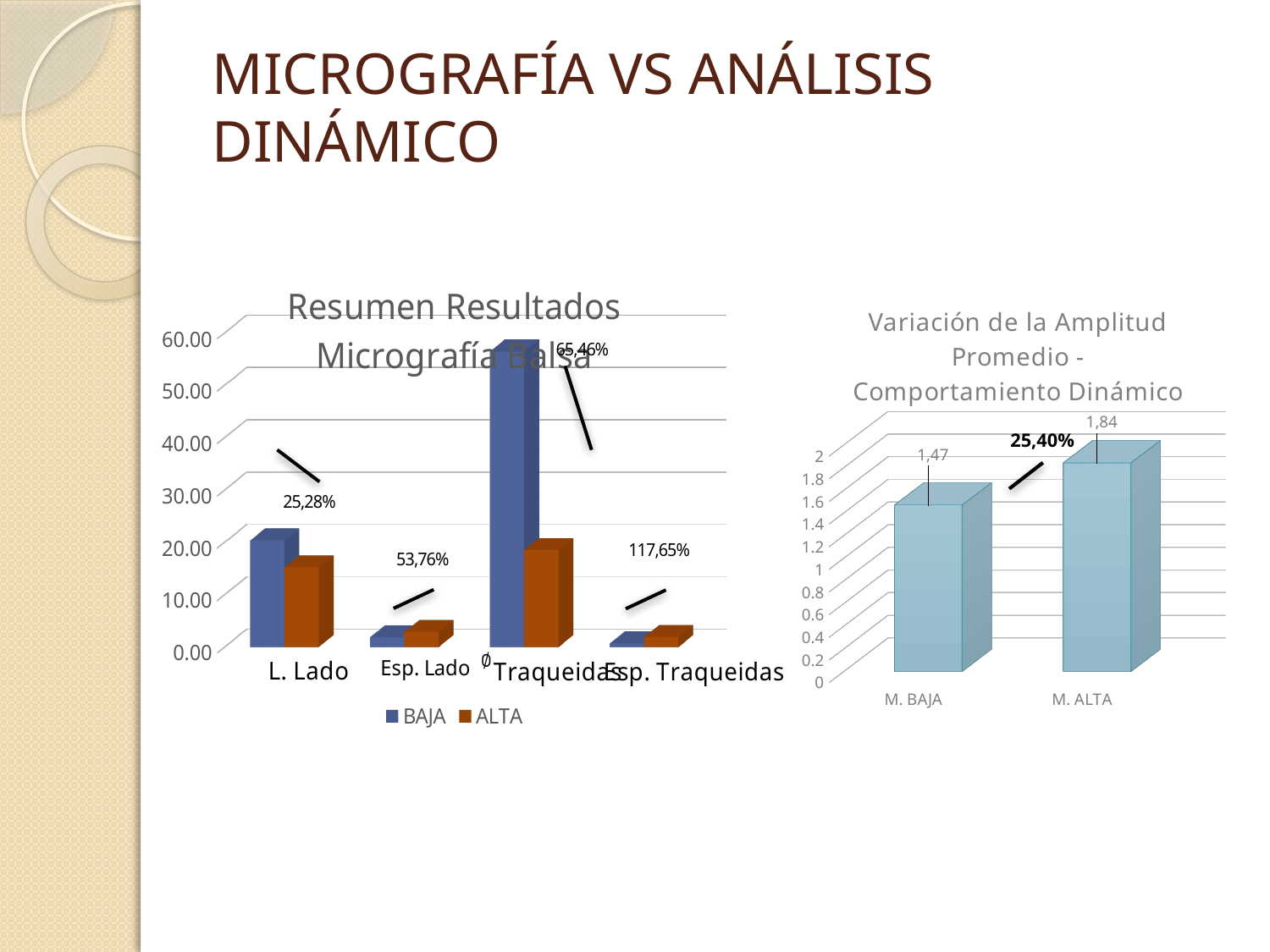
In the left-hand chart (Resumen Resultados Micrografía Balsa), is the BAJA value for Ø Traqueidas greater or less than 40.00? greater In the right-hand chart (Variación de la Amplitud Promedio), which category has the higher value? M. ALTA In the left-hand chart (Resumen Resultados Micrografía Balsa), for L. Lado, which series has the larger value, BAJA or ALTA? BAJA How many categories are shown on the x axis of the left-hand chart (Resumen Resultados Micrografía Balsa)? 4 In the right-hand chart (Variación de la Amplitud Promedio), what is the difference between the values for M. ALTA and M. BAJA? 0,37 How many series does the legend of the left-hand chart (Resumen Resultados Micrografía Balsa) list? 2 In the chart titled 'Variación de la Amplitud Promedio - Comportamiento Dinámico', what is the value for M. ALTA? 1,84 What kind of chart is the right-hand chart (Variación de la Amplitud Promedio)? bar chart In the chart titled 'Variación de la Amplitud Promedio - Comportamiento Dinámico', what is the value for M. BAJA? 1,47 How many categories are shown in the right-hand chart (Variación de la Amplitud Promedio)? 2 In the right-hand chart (Variación de la Amplitud Promedio), is the value for M. BAJA greater or less than 1? greater In the left-hand chart (Resumen Resultados Micrografía Balsa), which category has the highest BAJA value? Ø Traqueidas